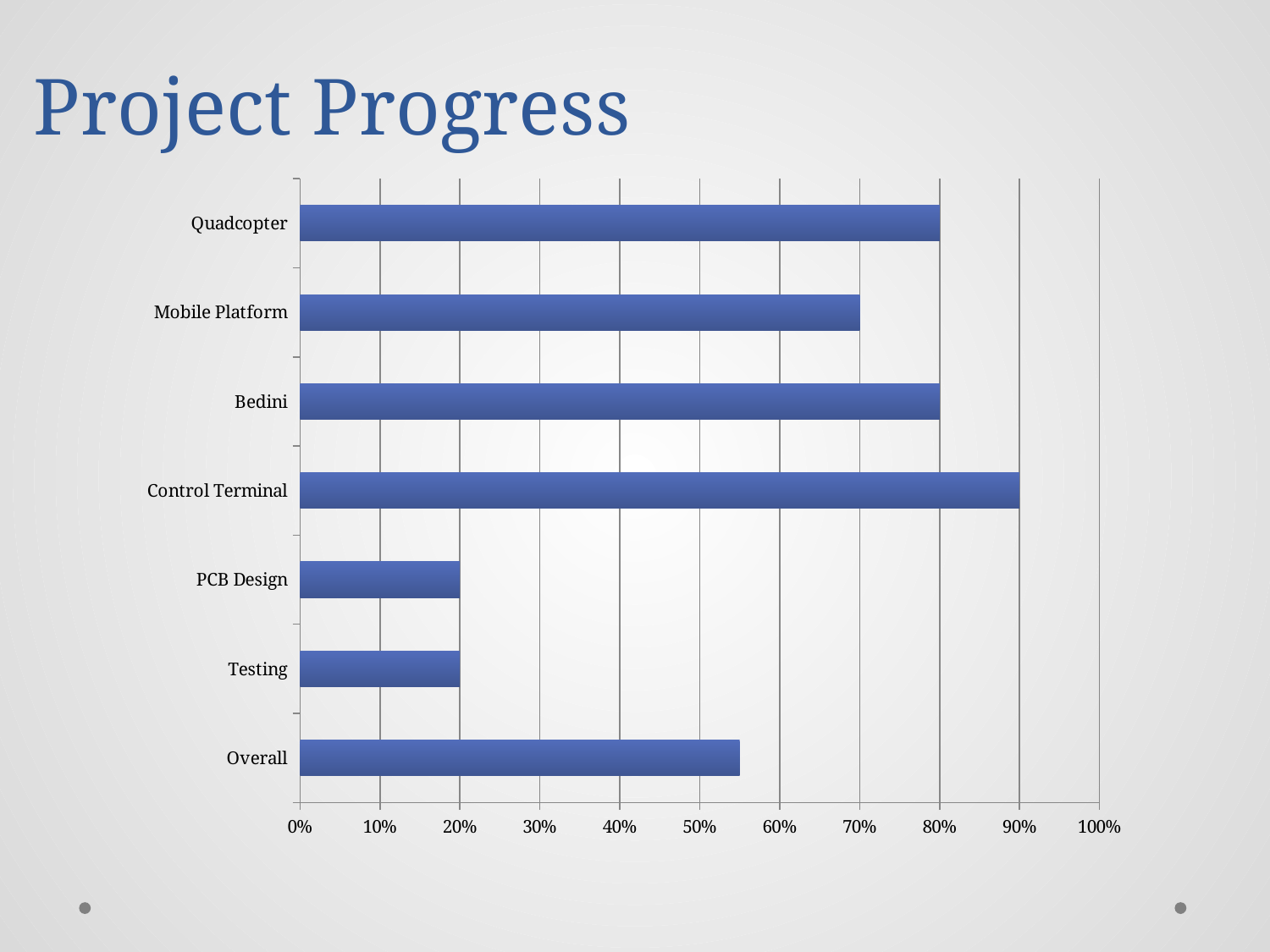
What is the value for Quadcopter? 80% What kind of chart is shown on the slide? bar chart Is the value for Overall greater or less than 60%? less Which is larger, the value for Quadcopter or the value for Mobile Platform? Quadcopter How many categories are shown in the chart? 7 What is the value for PCB Design? 20% What is the value for Mobile Platform? 70% What is the title of the slide? Project Progress What is the difference between the values for Control Terminal and Mobile Platform? 20% What is the value for Control Terminal? 90% Is the value for Overall greater or less than 50%? greater Which category has the highest value? Control Terminal